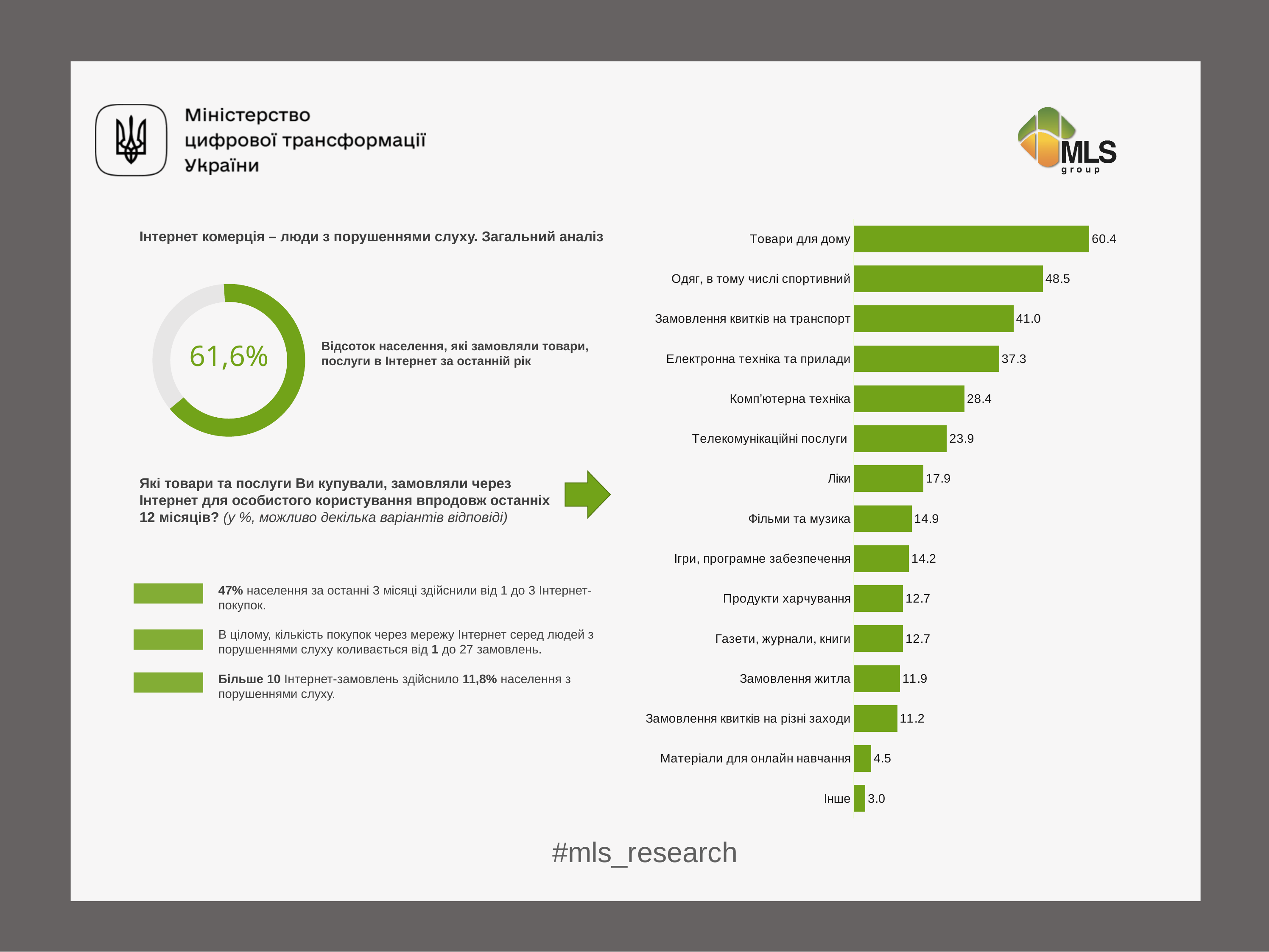
What kind of chart is shown on the left side of the slide with the value 61,6%? Donut chart In the bar chart on the right, which category has the lowest value? Інше In the bar chart on the right, which is larger: Комп'ютерна техніка or Телекомунікаційні послуги? Комп'ютерна техніка In the bar chart on the right, which category has the highest value? Товари для дому How many categories does the bar chart on the right show? 15 In the bar chart on the right, what is the difference between Одяг, в тому числі спортивний and Замовлення квитків на транспорт? 7.5 In the bar chart on the right, what is the value for Товари для дому? 60.4 What percentage is shown in the centre of the donut chart on the left? 61,6% In the bar chart on the right, what is the value for Матеріали для онлайн навчання? 4.5 In the bar chart on the right, what is the value for Ліки? 17.9 What kind of chart is shown on the right side of the slide? Bar chart In the bar chart on the right, what is the difference between Електронна техніка та прилади and Комп'ютерна техніка? 8.9